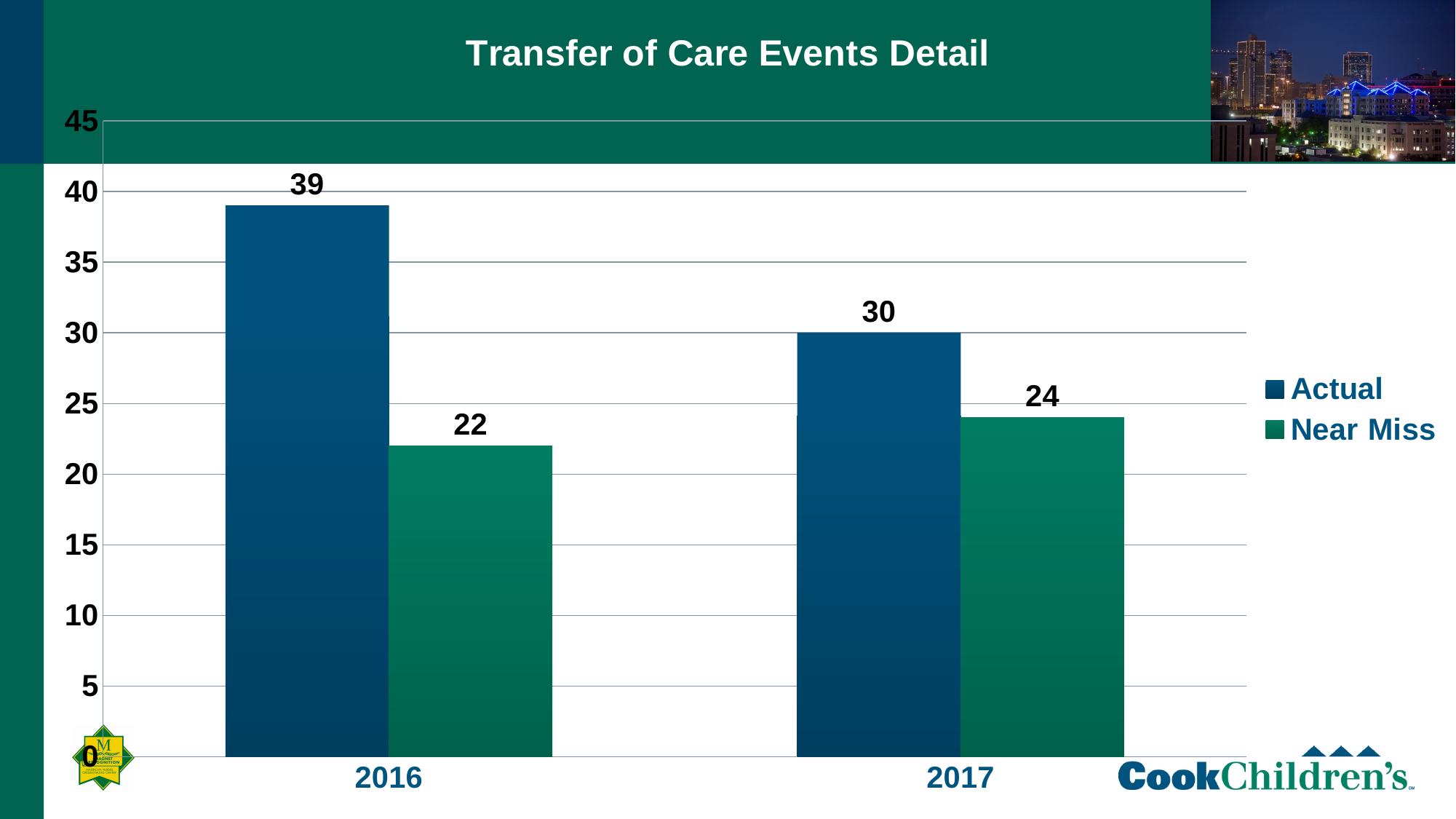
Which is larger in 2016, Actual or Near Miss? Actual What is the difference between the Actual values for 2016 and 2017? 9 How many series does the legend list? 2 What kind of chart is shown on the slide? bar chart What is the Actual value for 2016? 39 How many years are shown on the x axis? 2 What is the difference between the Actual and Near Miss values in 2017? 6 What is the Near Miss value for 2016? 22 What is the Near Miss value for 2017? 24 Which year has the lowest Near Miss value? 2016 What is the title of the chart? Transfer of Care Events Detail Which year has the highest Actual value? 2016